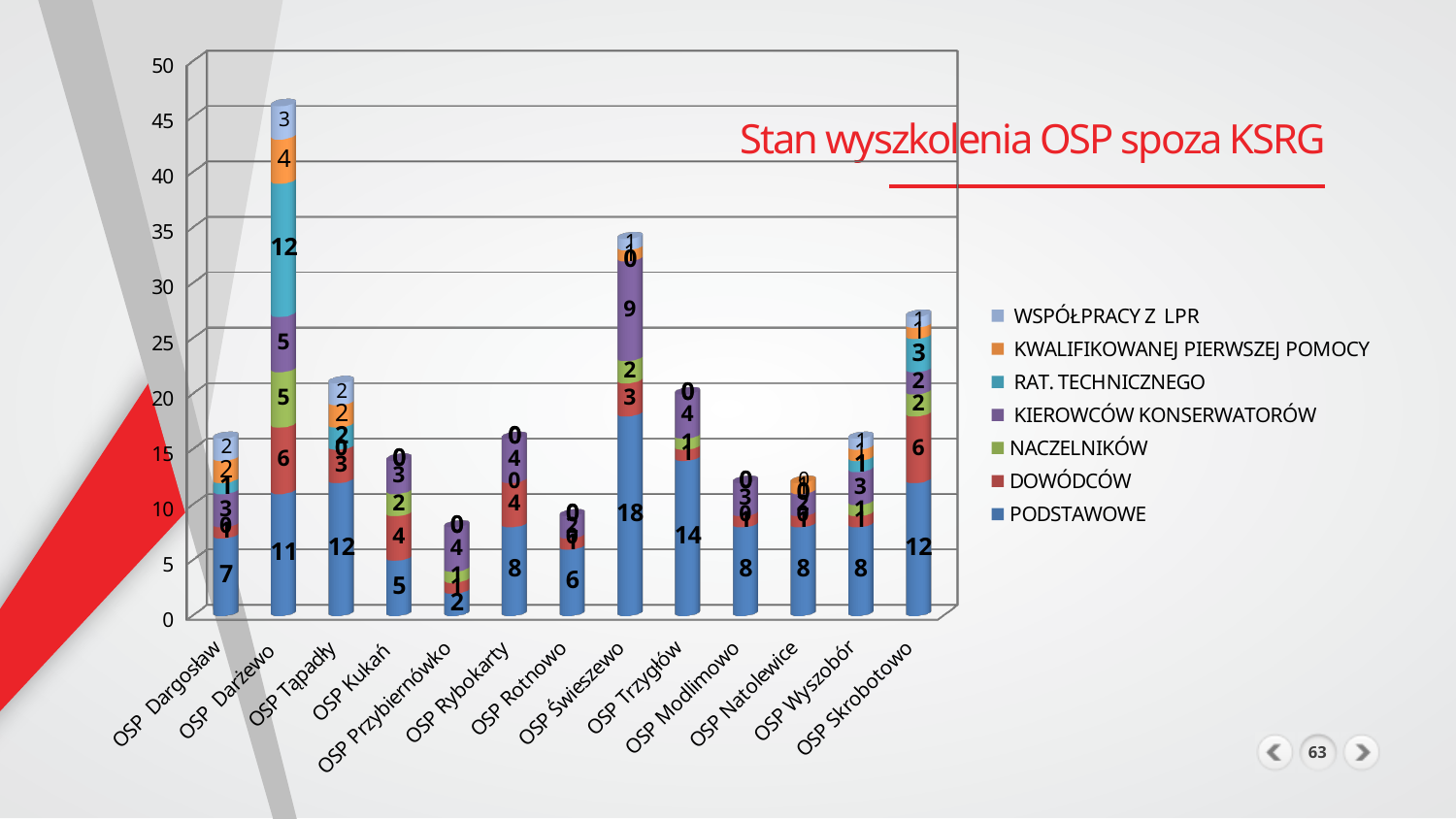
What is the title of the chart? Stan wyszkolenia OSP spoza KSRG What kind of chart is shown on the slide? Stacked bar chart How many OSP units are shown on the x axis? 13 What is the PODSTAWOWE value for OSP Świeszewo? 18 Which has the larger PODSTAWOWE value, OSP Darżewo or OSP Tąpadły? OSP Tąpadły Which OSP unit has the lowest PODSTAWOWE value? OSP Przybiernówko How many series does the legend list? 7 What is the total of the stacked bar for OSP Darżewo? 46 What is the DOWÓDCÓW value for OSP Skrobotowo? 6 Which OSP unit has the highest PODSTAWOWE value? OSP Świeszewo What is the difference between the PODSTAWOWE values for OSP Świeszewo and OSP Trzygłów? 4 What is the RAT. TECHNICZNEGO value for OSP Darżewo? 12